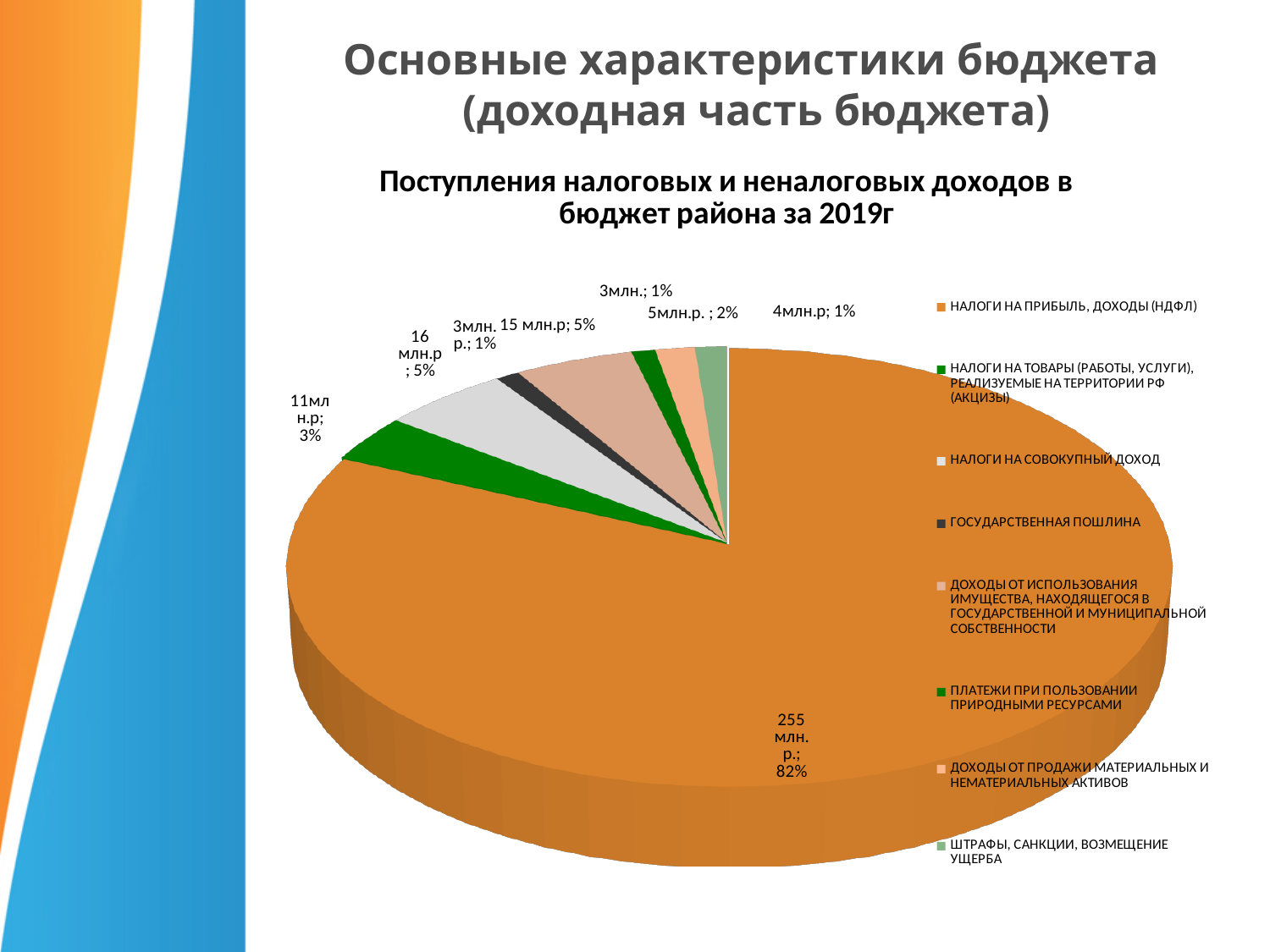
What share of the pie does НАЛОГИ НА ТОВАРЫ (РАБОТЫ, УСЛУГИ), РЕАЛИЗУЕМЫЕ НА ТЕРРИТОРИИ РФ (АКЦИЗЫ) account for? 3% What is the value shown for НАЛОГИ НА ПРИБЫЛЬ, ДОХОДЫ (НДФЛ)? 255 млн. р. How many categories does the legend of the pie chart list? 8 Which category has the largest slice of the pie? НАЛОГИ НА ПРИБЫЛЬ, ДОХОДЫ (НДФЛ) What share of the pie does ДОХОДЫ ОТ ПРОДАЖИ МАТЕРИАЛЬНЫХ И НЕМАТЕРИАЛЬНЫХ АКТИВОВ account for? 2% Which is larger: the slice for НАЛОГИ НА СОВОКУПНЫЙ ДОХОД or the slice for ГОСУДАРСТВЕННАЯ ПОШЛИНА? НАЛОГИ НА СОВОКУПНЫЙ ДОХОД What type of chart is shown on the slide? pie chart What is the title of the pie chart? Поступления налоговых и неналоговых доходов в бюджет района за 2019г What is the value shown for НАЛОГИ НА СОВОКУПНЫЙ ДОХОД? 16 млн.р What share of the pie does НАЛОГИ НА СОВОКУПНЫЙ ДОХОД account for? 5% What is the difference in percentage points between the share for НАЛОГИ НА ПРИБЫЛЬ, ДОХОДЫ (НДФЛ) and the share for НАЛОГИ НА СОВОКУПНЫЙ ДОХОД? 77